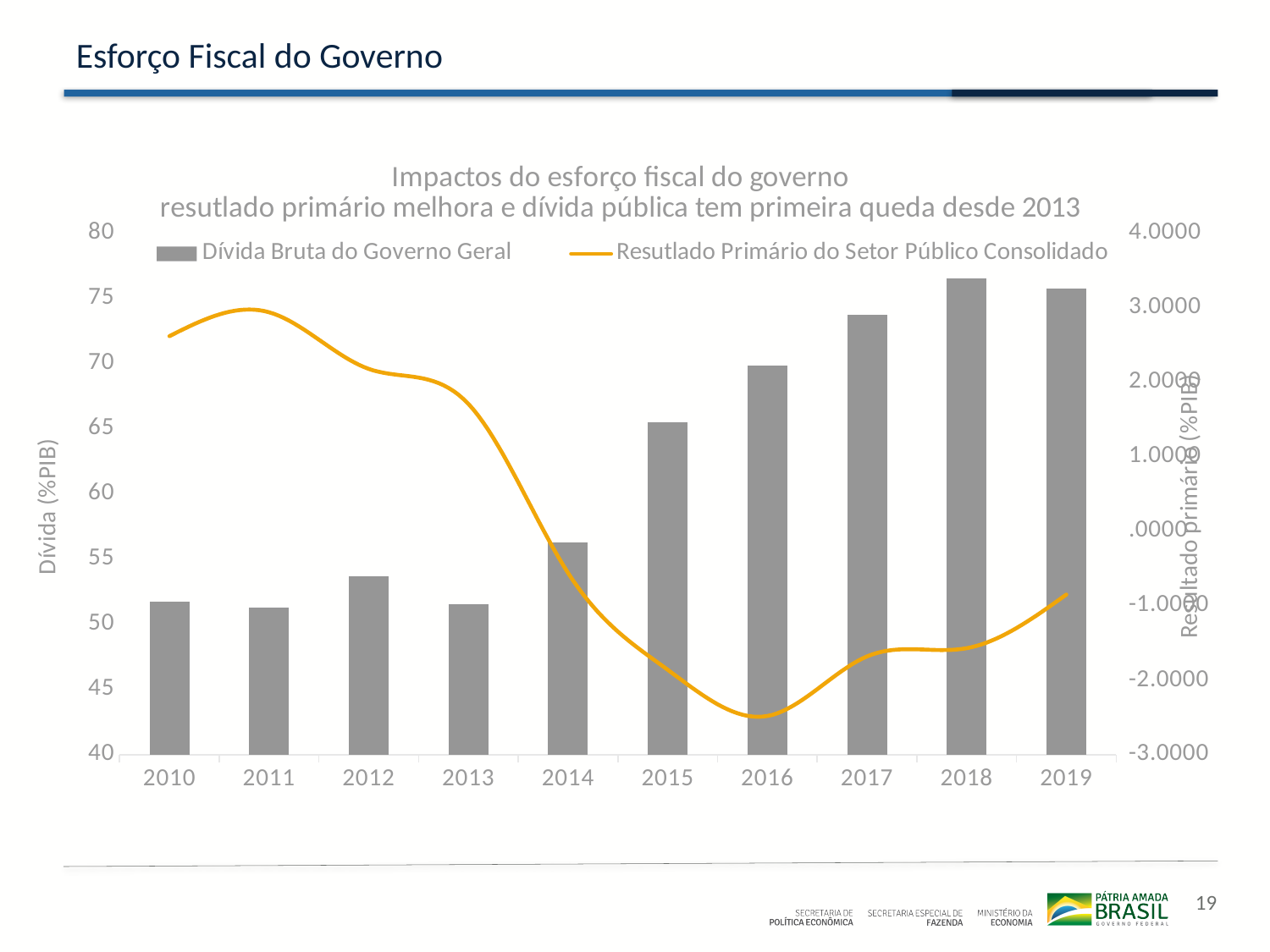
Do the Dívida Bruta do Governo Geral bars rise or fall from 2013 to 2018? rise Which year has the highest bar for Dívida Bruta do Governo Geral? 2018 Is the Dívida Bruta do Governo Geral bar for 2012 greater or less than 55? less In which year does the Resultado Primário do Setor Público Consolidado line reach its lowest point? 2016 How many years are shown on the x axis? 10 In which year does the Resultado Primário do Setor Público Consolidado line reach its highest point? 2011 Is the Dívida Bruta do Governo Geral bar for 2017 greater or less than 70? greater Is the Resultado Primário value for 2016 greater or less than -2.0000? less Which year has the larger Dívida Bruta do Governo Geral bar, 2015 or 2017? 2017 What kind of chart is shown on the slide? A combined bar and line chart How many series does the legend list? 2